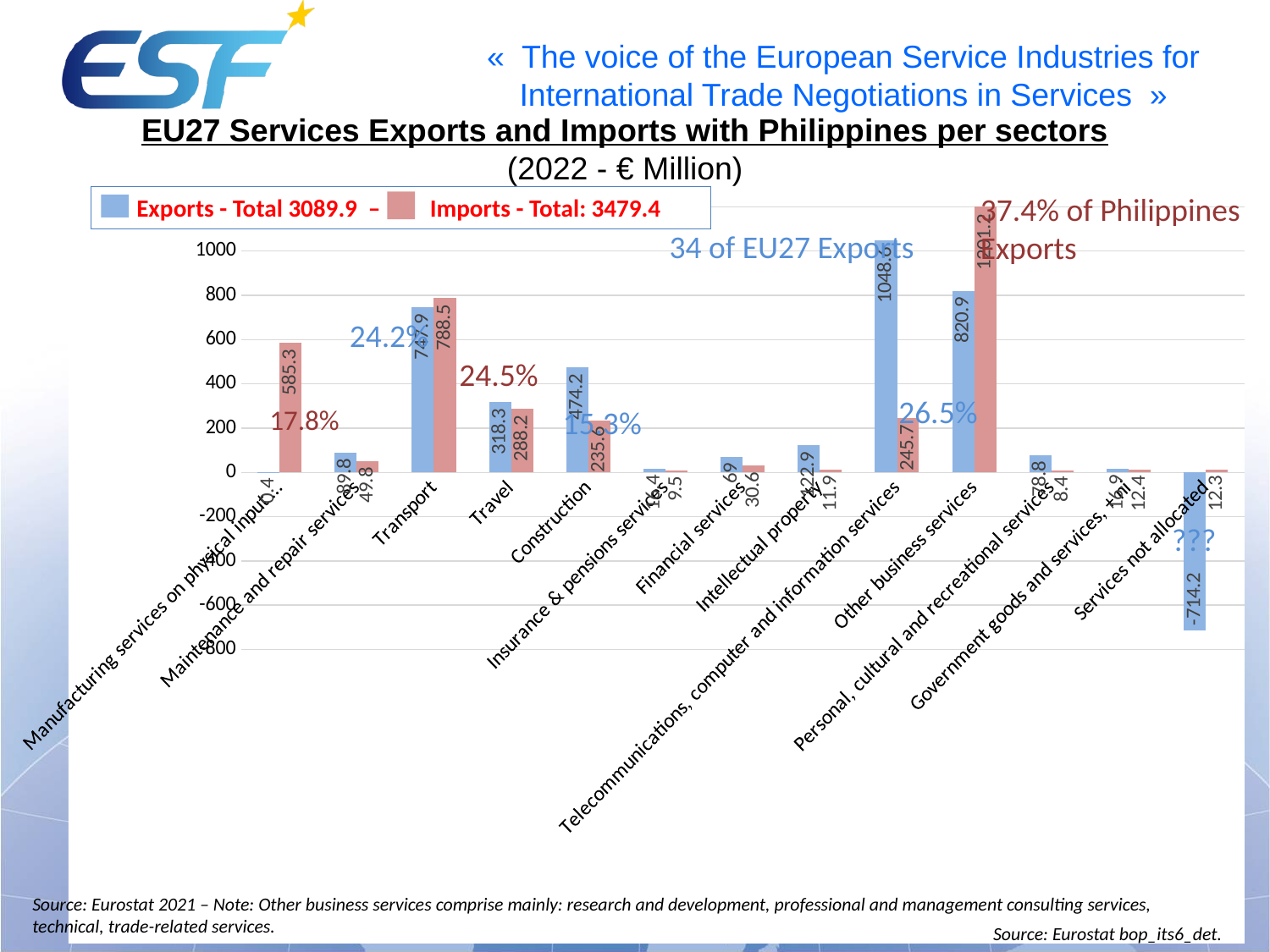
What is the exports value for Telecommunications, computer and information services? 1048.6 What is the value of EU27 imports from the Philippines for Transport? 788.5 For Transport, which is larger: exports or imports? Imports What kind of chart is shown on the slide? bar chart Which sector has the highest exports value? Telecommunications, computer and information services Is the imports value for Manufacturing services on physical inputs greater or less than 400? greater How many series does the legend list? 2 What is the imports value for Construction? 235.6 According to the legend, what is the total of exports? 3089.9 What is the difference between exports and imports for Travel? 30.1 Which sector has the lowest exports value? Services not allocated What is the value of EU27 exports to the Philippines for Transport? 747.9